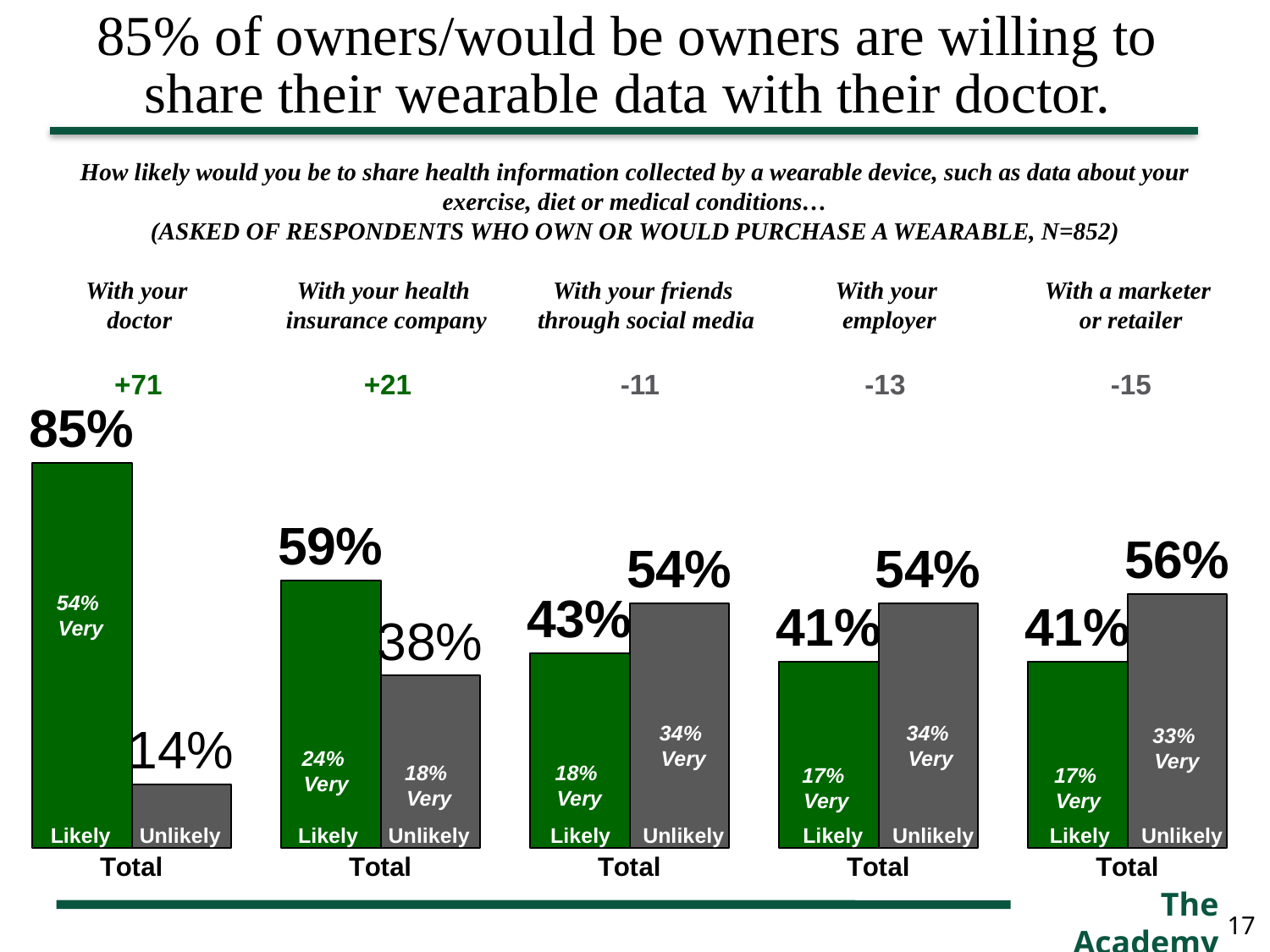
How many bars are in the 'With your employer' chart? 2 In the 'With your health insurance company' chart, what share of the Likely bar is labelled 'Very'? 24% In the 'With your doctor' chart, what is the difference between the Likely and Unlikely bars? 71 Across the five charts, which one has the highest Likely value? With your doctor What kind of chart is used for each of the five sharing scenarios? Bar chart In the 'With a marketer or retailer' chart, what is the value of the Unlikely bar? 56% In the 'With your employer' chart, what is the difference between the Unlikely and Likely bars? 13 Across the five charts, which one has the lowest Unlikely value? With your doctor In the 'With your friends through social media' chart, which bar is taller, Likely or Unlikely? Unlikely In the 'With your doctor' chart, what is the value of the Unlikely bar? 14% In the 'With your health insurance company' chart, what is the value of the Unlikely bar? 38% In the 'With your doctor' chart, what is the value of the Likely bar? 85%